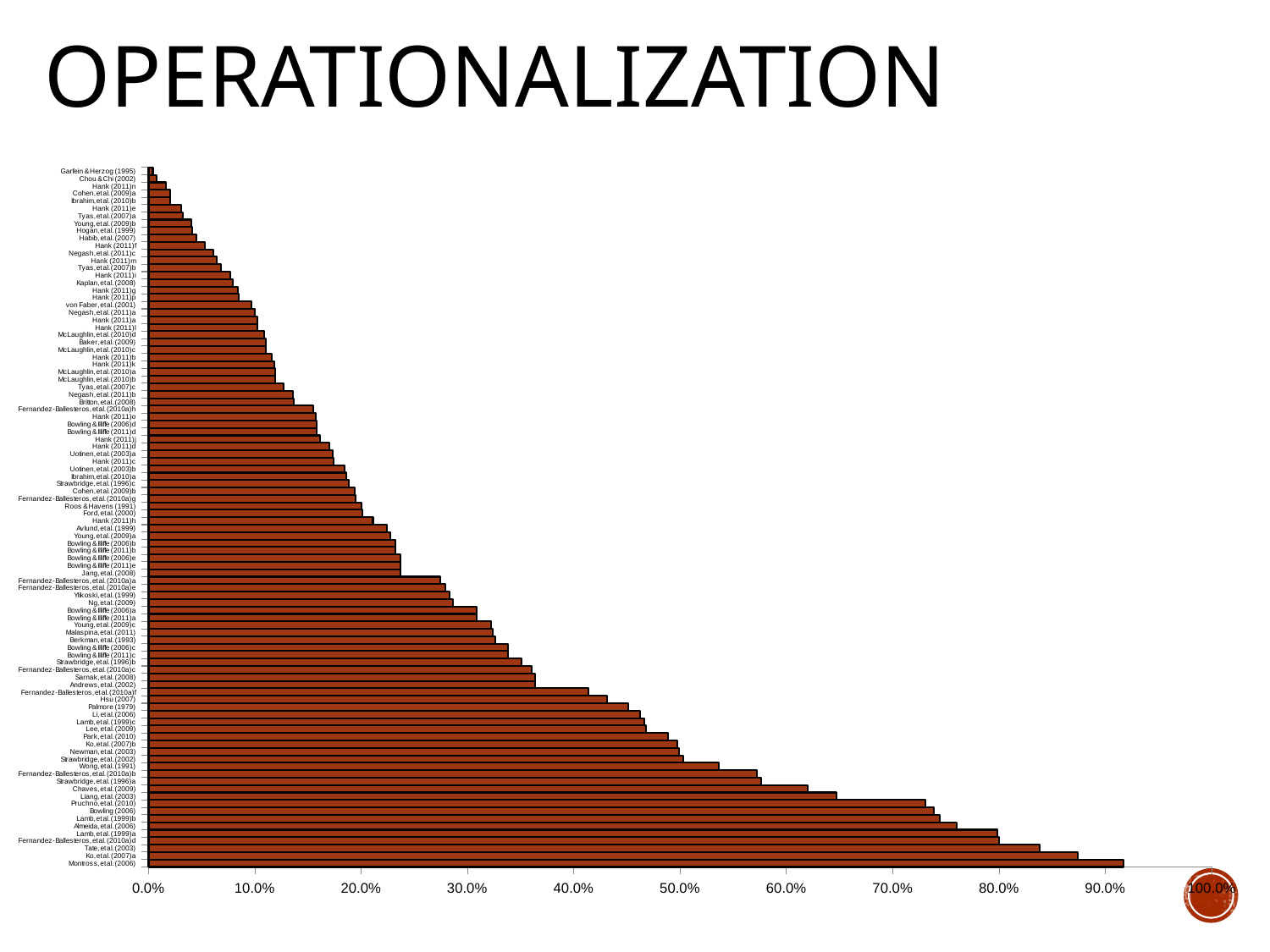
What kind of chart is shown on the slide? bar chart Do the bar values increase or decrease going from the top of the chart to the bottom? increase Which has the larger value, Montross, et al. (2006) or Garfein & Herzog (1995)? Montross, et al. (2006) Is the value for Palmore (1979) greater or less than 50.0%? less Which category has the lowest value in the chart? Garfein & Herzog (1995) What is the title of the slide containing the chart? OPERATIONALIZATION Is the value for Garfein & Herzog (1995) greater or less than 10.0%? less Which has the larger value, Ko, et al. (2007)a or Palmore (1979)? Ko, et al. (2007)a Is the value for Pruchno, et al. (2010) greater or less than 70.0%? greater Which category has the highest value in the chart? Montross, et al. (2006)